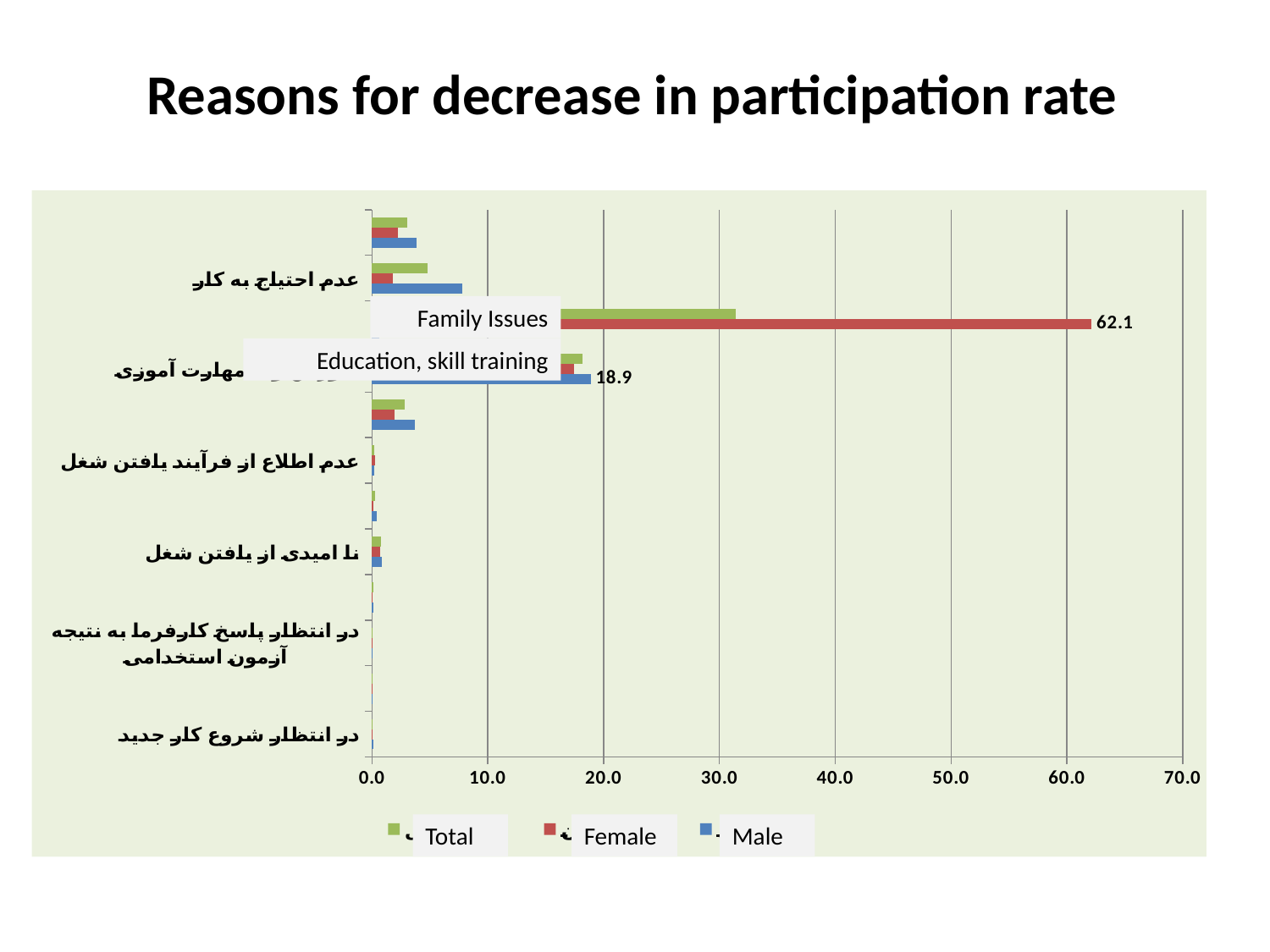
Which is larger: the Female value for Family Issues or the Male value for Education, skill training? Female value for Family Issues What is the title of the slide's chart? Reasons for decrease in participation rate What is the highest value shown on the horizontal axis? 70.0 What is the Male value for Education, skill training? 18.9 What kind of chart is shown on the slide? bar chart Is the Total value for Family Issues greater or less than 40? less What is the Female value for Family Issues? 62.1 What are the series listed in the legend? Total, Female, Male Is the Female value for Family Issues greater or less than 60? greater How many series does the legend list? 3 What is the difference between the Female value for Family Issues (62.1) and the Male value for Education, skill training (18.9)? 43.2 Which series has the highest value for Family Issues? Female